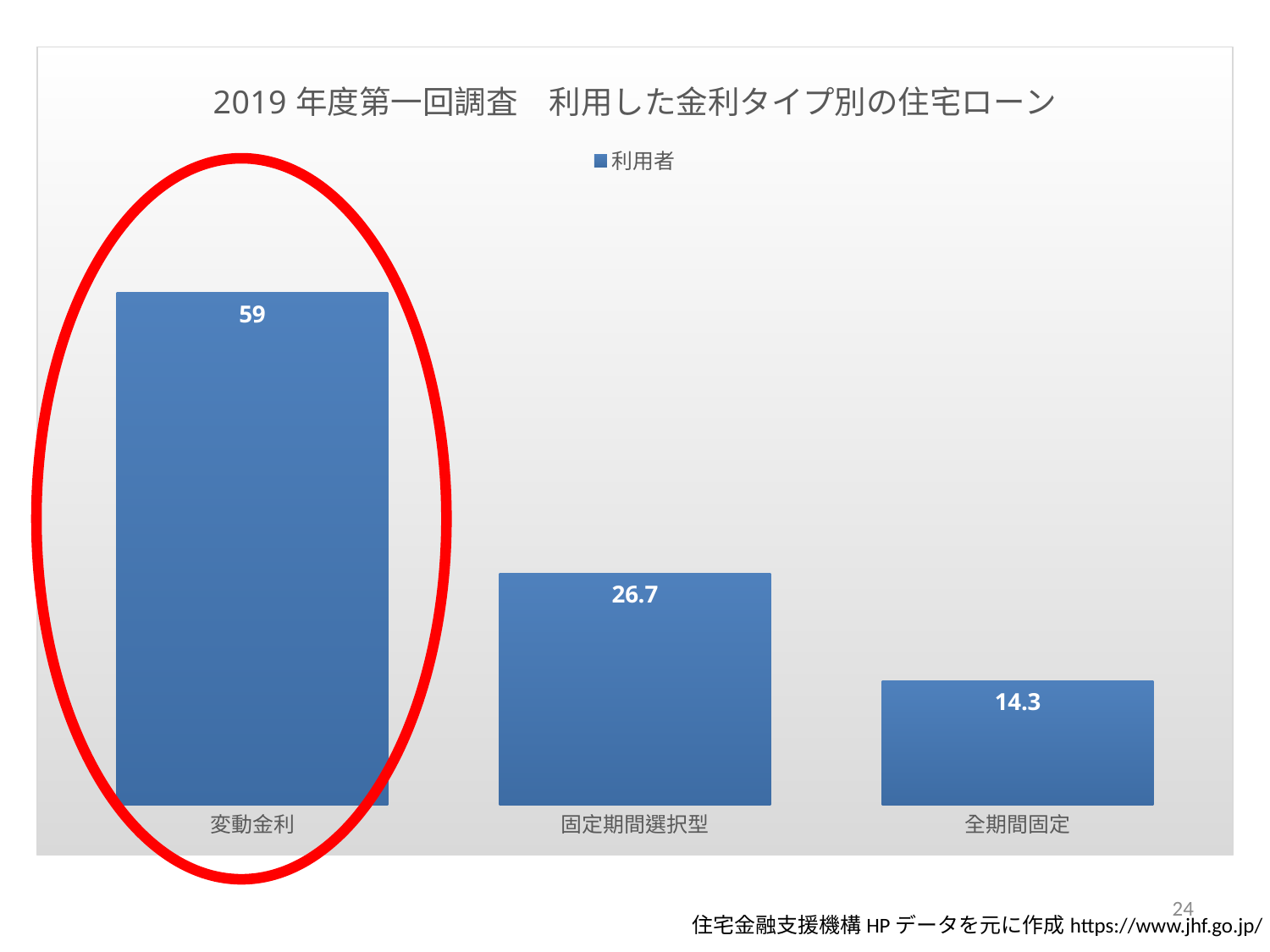
What is the difference between the values for 変動金利 and 固定期間選択型? 32.3 Which category has the lowest value? 全期間固定 What is the value for 全期間固定? 14.3 What is the difference between the values for 固定期間選択型 and 全期間固定? 12.4 What is the value for 変動金利? 59 Which category has the highest value? 変動金利 How many series does the legend list? 1 What is the name of the series shown in the legend? 利用者 What kind of chart is shown on the slide? bar chart How many categories are shown on the x axis? 3 What is the value for 固定期間選択型? 26.7 Which is larger, the value for 固定期間選択型 or the value for 全期間固定? 固定期間選択型